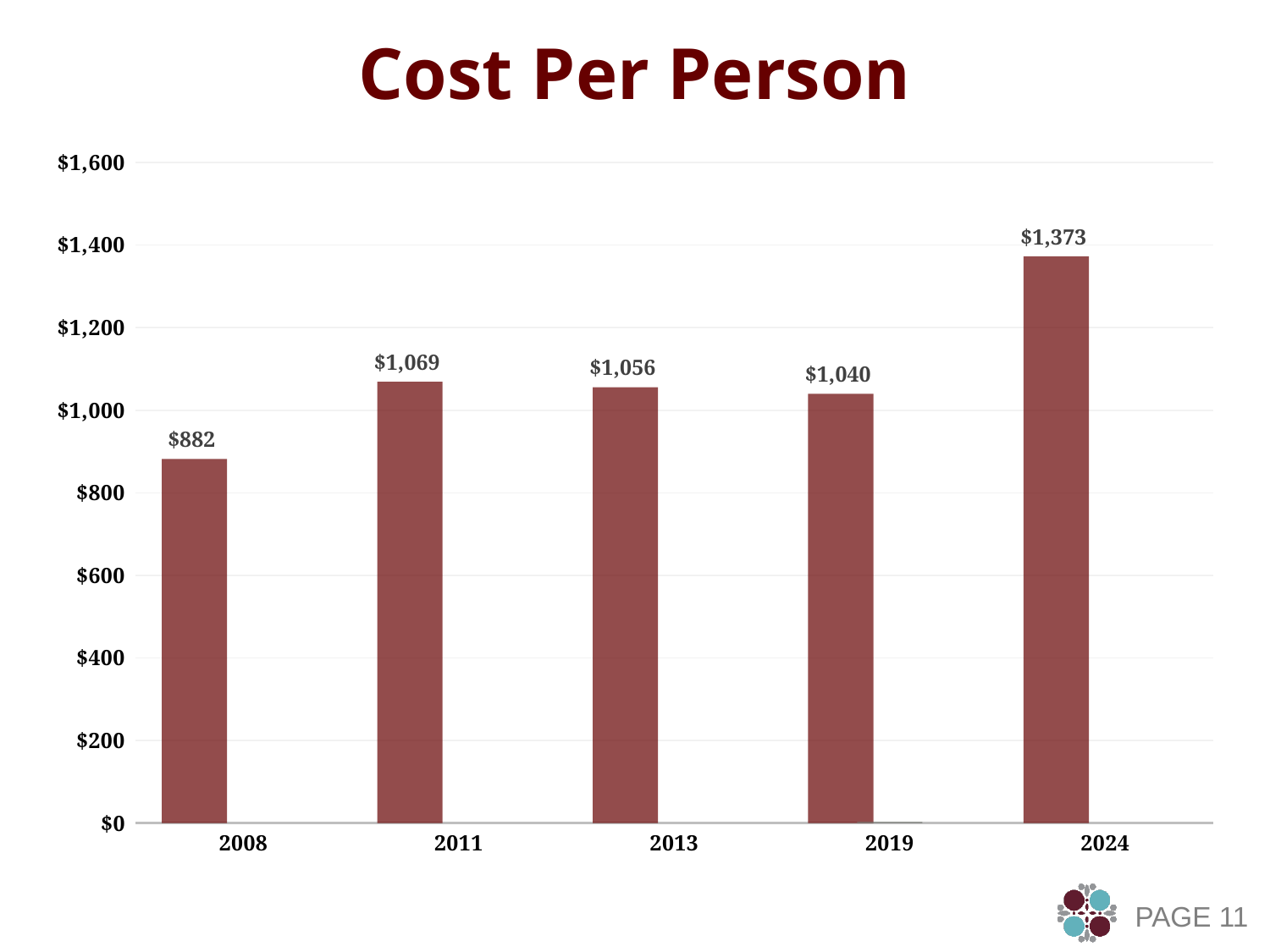
What is the title of the chart? Cost Per Person What kind of chart is shown on the slide? Bar chart Which year has the lowest cost per person? 2008 Is the cost per person in 2024 greater or less than $1,200? greater How many years are shown on the chart? 5 What is the difference between the cost per person in 2011 and in 2008? $187 Which year has the highest cost per person? 2024 What is the cost per person in 2024? $1,373 Which year has a higher cost per person, 2008 or 2019? 2019 What is the cost per person in 2008? $882 What is the difference between the cost per person in 2024 and in 2019? $333 What is the cost per person in 2013? $1,056